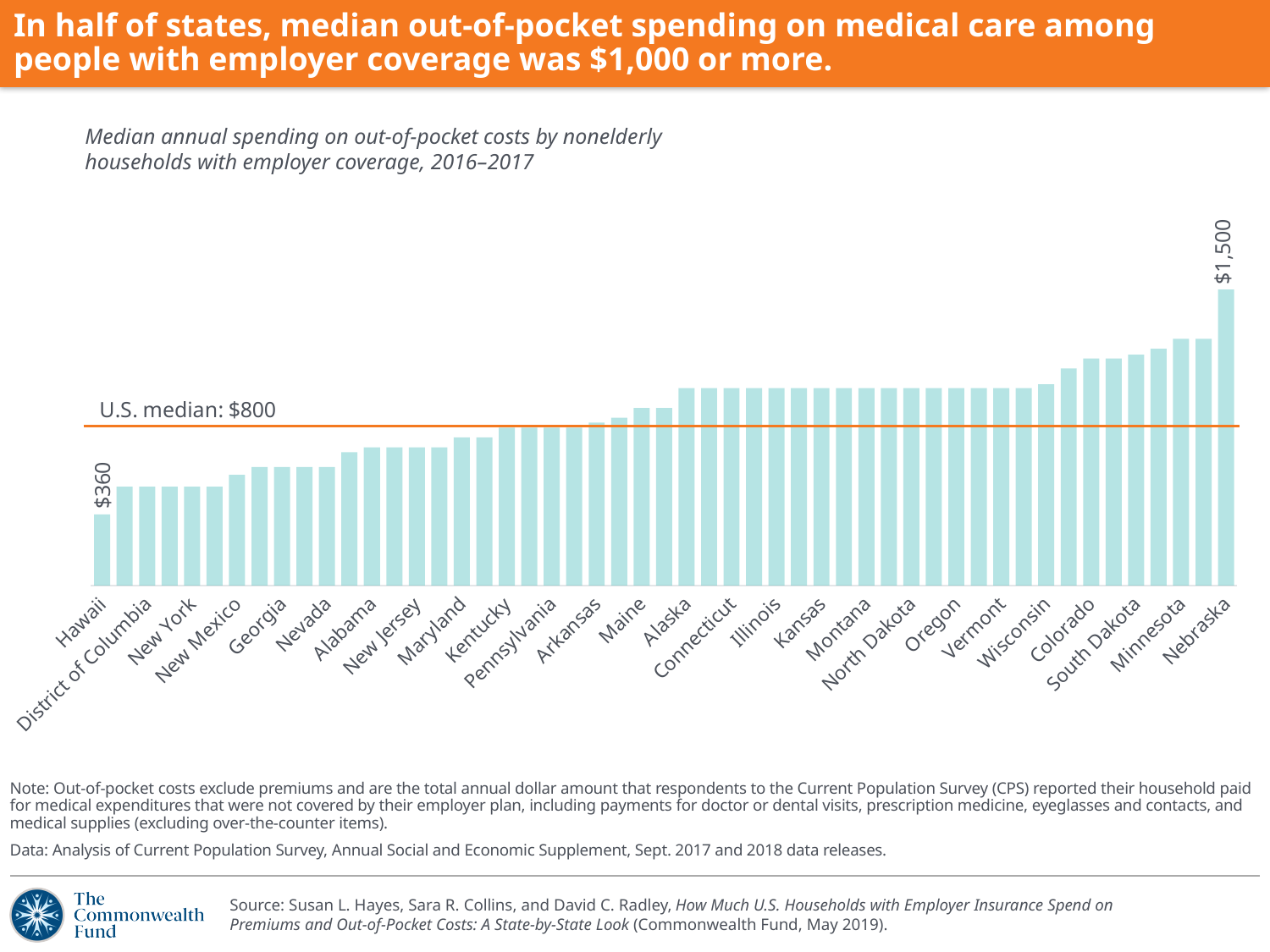
What is the median annual out-of-pocket spending shown for Hawaii? $360 Which state has the lowest median out-of-pocket spending in the chart? Hawaii Which has the higher median out-of-pocket spending, Minnesota or Georgia? Minnesota Which state has the highest median out-of-pocket spending in the chart? Nebraska Is the value for New York greater or less than the U.S. median of $800? less What time period does the chart subtitle say the data covers? 2016–2017 What kind of chart is shown on the slide? bar chart What is the median annual out-of-pocket spending shown for Nebraska? $1,500 What U.S. median value is marked by the horizontal line on the chart? $800 What is the difference between the median out-of-pocket spending for Nebraska and for Hawaii? $1,140 Do the bar values rise or fall moving from left to right along the x axis? rise Is the value for Colorado greater or less than the U.S. median of $800? greater